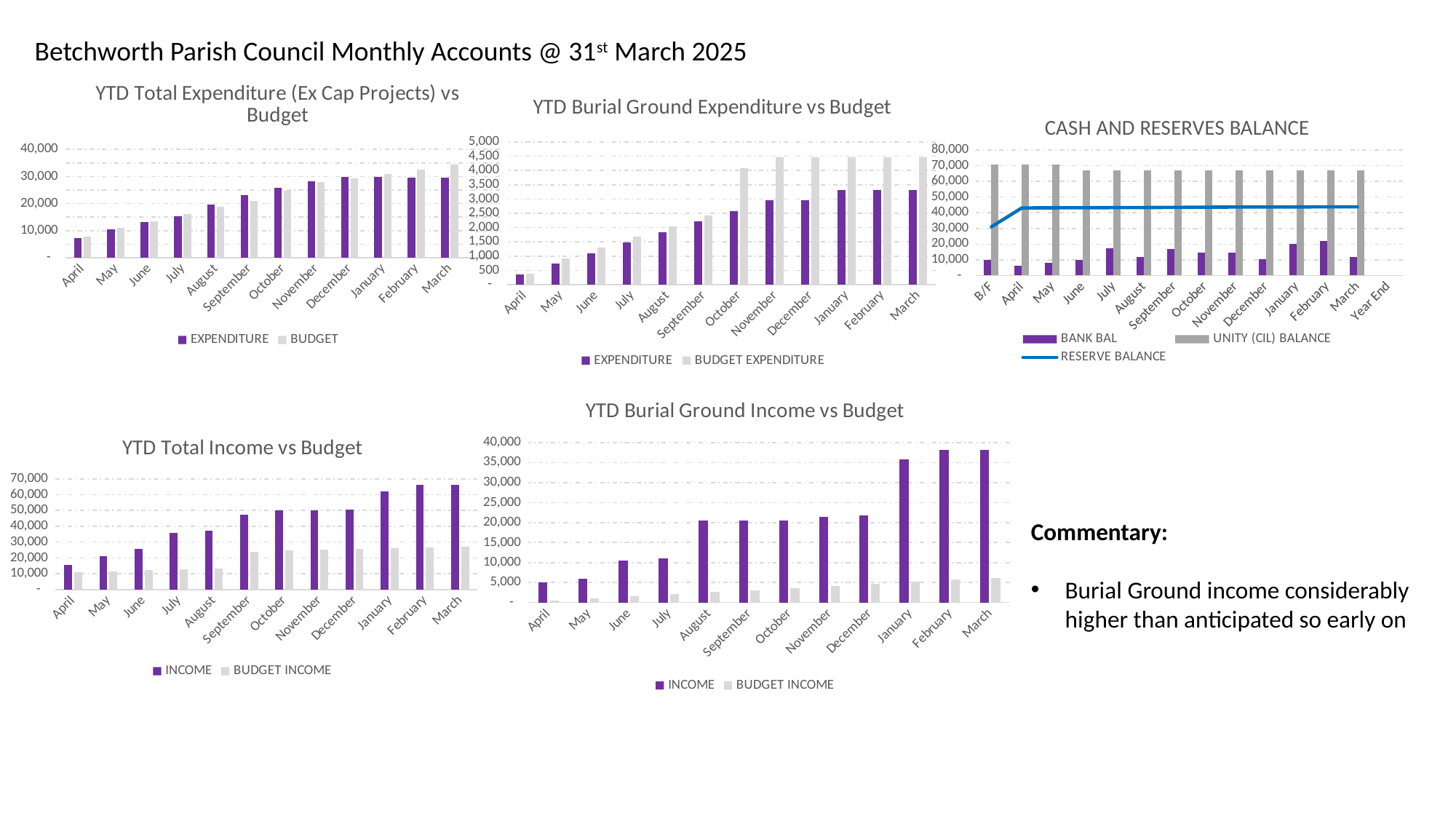
How many categories are shown on the x axis of the 'CASH AND RESERVES BALANCE' chart? 14 In the 'YTD Burial Ground Expenditure vs Budget' chart, which is larger for March: EXPENDITURE or BUDGET EXPENDITURE? BUDGET EXPENDITURE In the 'YTD Total Income vs Budget' chart, is the INCOME value for March greater or less than 60,000? greater In the 'YTD Total Income vs Budget' chart, which is larger for March: INCOME or BUDGET INCOME? INCOME In the 'YTD Total Expenditure (Ex Cap Projects) vs Budget' chart, do the EXPENDITURE values rise or fall from April to March? Rise How many series does the legend of the 'YTD Total Expenditure (Ex Cap Projects) vs Budget' chart list? 2 How many series does the legend of the 'CASH AND RESERVES BALANCE' chart list? 3 In the 'CASH AND RESERVES BALANCE' chart, is the UNITY (CIL) BALANCE value for B/F greater or less than 60,000? greater What are the legend entries of the 'CASH AND RESERVES BALANCE' chart? BANK BAL, UNITY (CIL) BALANCE, RESERVE BALANCE What kind of chart is the 'YTD Total Expenditure (Ex Cap Projects) vs Budget' chart? Bar chart In the 'YTD Burial Ground Expenditure vs Budget' chart, is the BUDGET EXPENDITURE value for March greater or less than 4,000? greater How many months are shown on the x axis of the 'YTD Total Expenditure (Ex Cap Projects) vs Budget' chart? 12